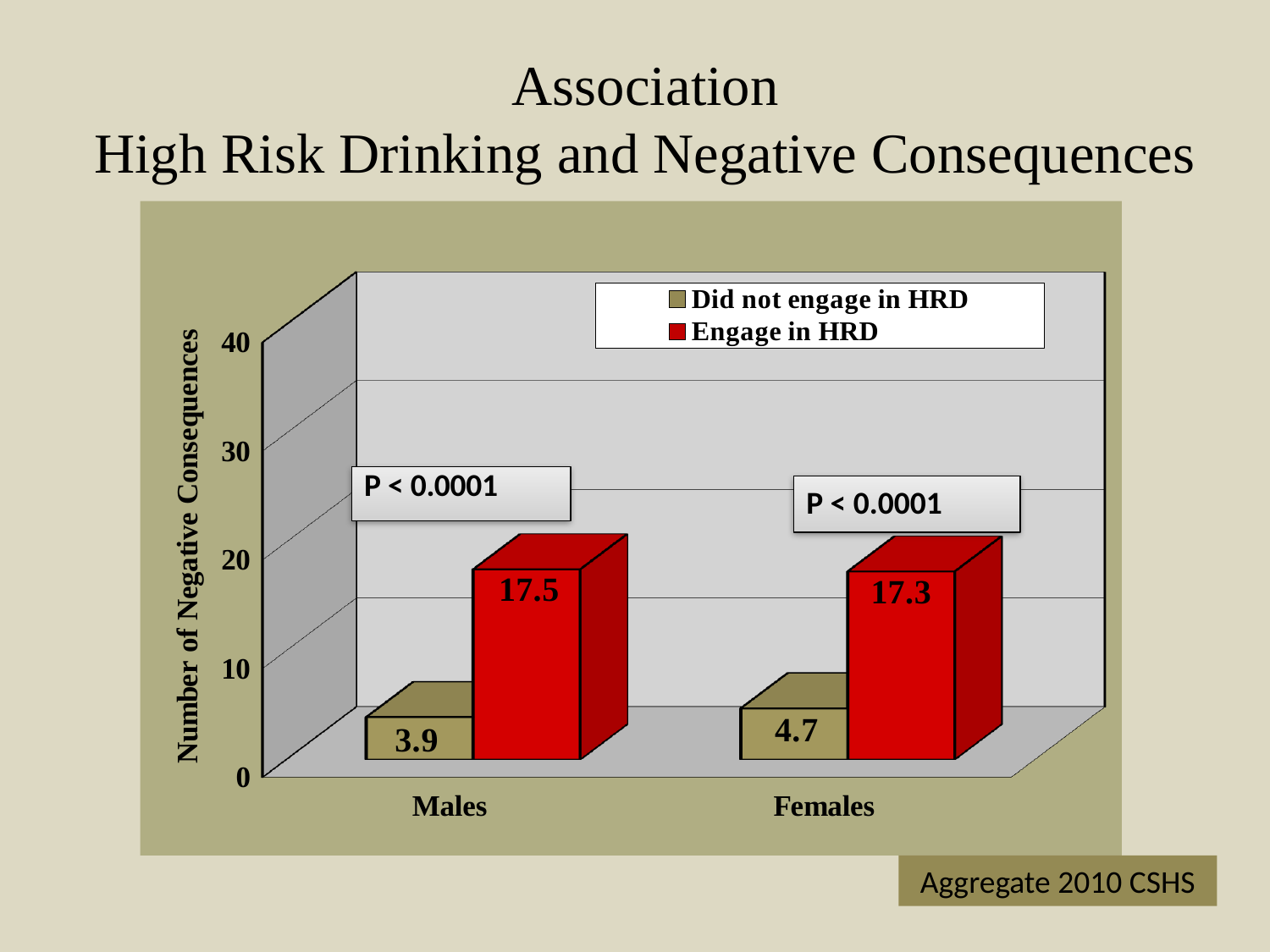
How many series does the legend list? 2 What is the number of negative consequences for Males who did not engage in HRD? 3.9 Which is larger: the value for Females who did not engage in HRD or Males who did not engage in HRD? Females who did not engage in HRD What is the number of negative consequences for Females who engage in HRD? 17.3 What is the difference in negative consequences between Females who engage in HRD and Females who did not engage in HRD? 12.6 What is the number of negative consequences for Females who did not engage in HRD? 4.7 Which group has the highest number of negative consequences? Males who engage in HRD What is the difference in negative consequences between Males who engage in HRD and Males who did not engage in HRD? 13.6 What is the label of the y axis? Number of Negative Consequences What kind of chart is shown on the slide? Bar chart What is the number of negative consequences for Males who engage in HRD? 17.5 Which group has the lowest number of negative consequences? Males who did not engage in HRD